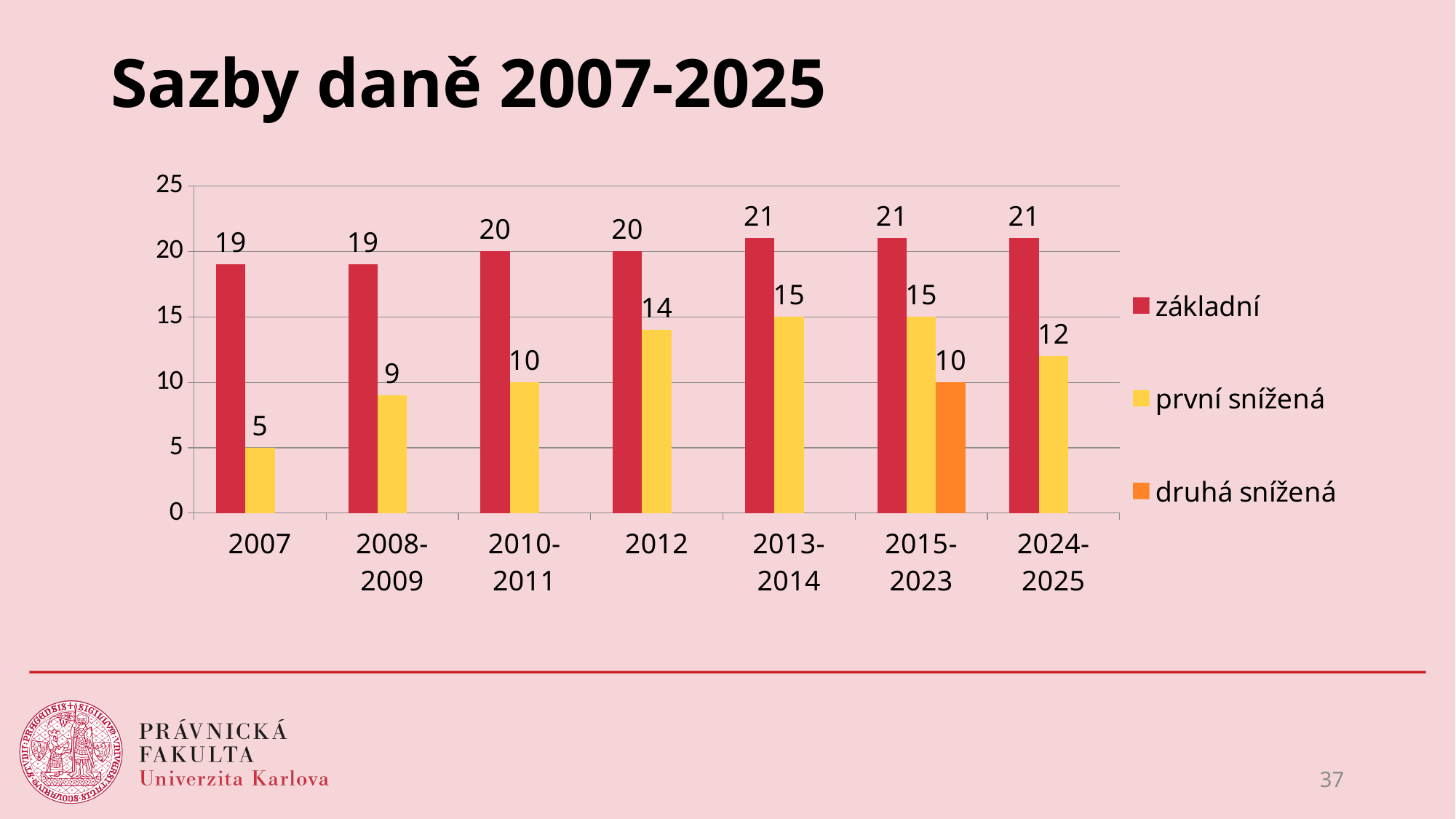
How many series does the legend list? 3 Which is larger for 2010-2011: the základní value or the první snížená value? základní What is the title of the slide? Sazby daně 2007-2025 How many categories are shown on the x axis? 7 Does the základní series rise or fall from 2007 to 2024-2025? rise What kind of chart is shown on the slide? bar chart What is the difference between the základní and první snížená values for 2008-2009? 10 What is the value of the základní series for 2007? 19 What is the value of the první snížená series for 2024-2025? 12 What is the value of the první snížená series for 2012? 14 In which category is the první snížená value lowest? 2007 What is the value of the druhá snížená series for 2015-2023? 10